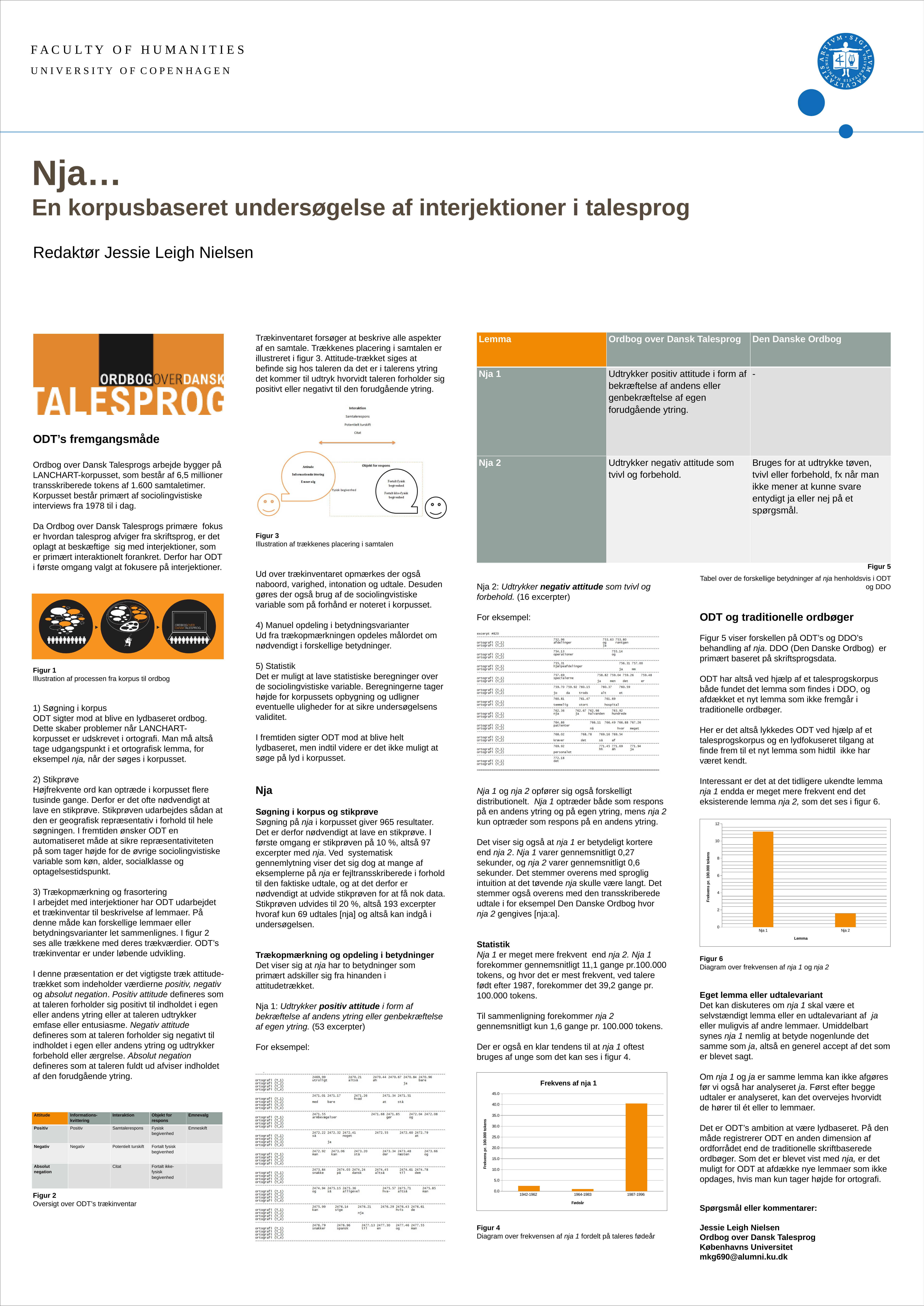
In the 'Frekvens af nja 1' chart, is the value for 1942-1962 greater or less than 5.0? less What is the y-axis label of the Figur 6 chart (bottom right)? Frekvens pr. 100.000 tokens In the 'Frekvens af nja 1' chart, how many birth-year categories are shown on the x axis? 3 In the Figur 6 chart (bottom right), is the value for Nja 2 greater or less than 4? less In the 'Frekvens af nja 1' chart, which birth-year category has the highest frequency? 1987-1996 What is the x-axis label of the 'Frekvens af nja 1' chart? Fødeår In the Figur 6 chart (bottom right), is the value for Nja 1 greater or less than 8? greater In the 'Frekvens af nja 1' chart, which birth-year category has the lowest frequency? 1964-1983 In the 'Frekvens af nja 1' chart, which is larger: the value for 1942-1962 or the value for 1964-1983? 1942-1962 In the Figur 6 chart (bottom right), which lemma has the higher frequency, Nja 1 or Nja 2? Nja 1 What kind of chart is the 'Frekvens af nja 1' chart (Figur 4)? bar chart